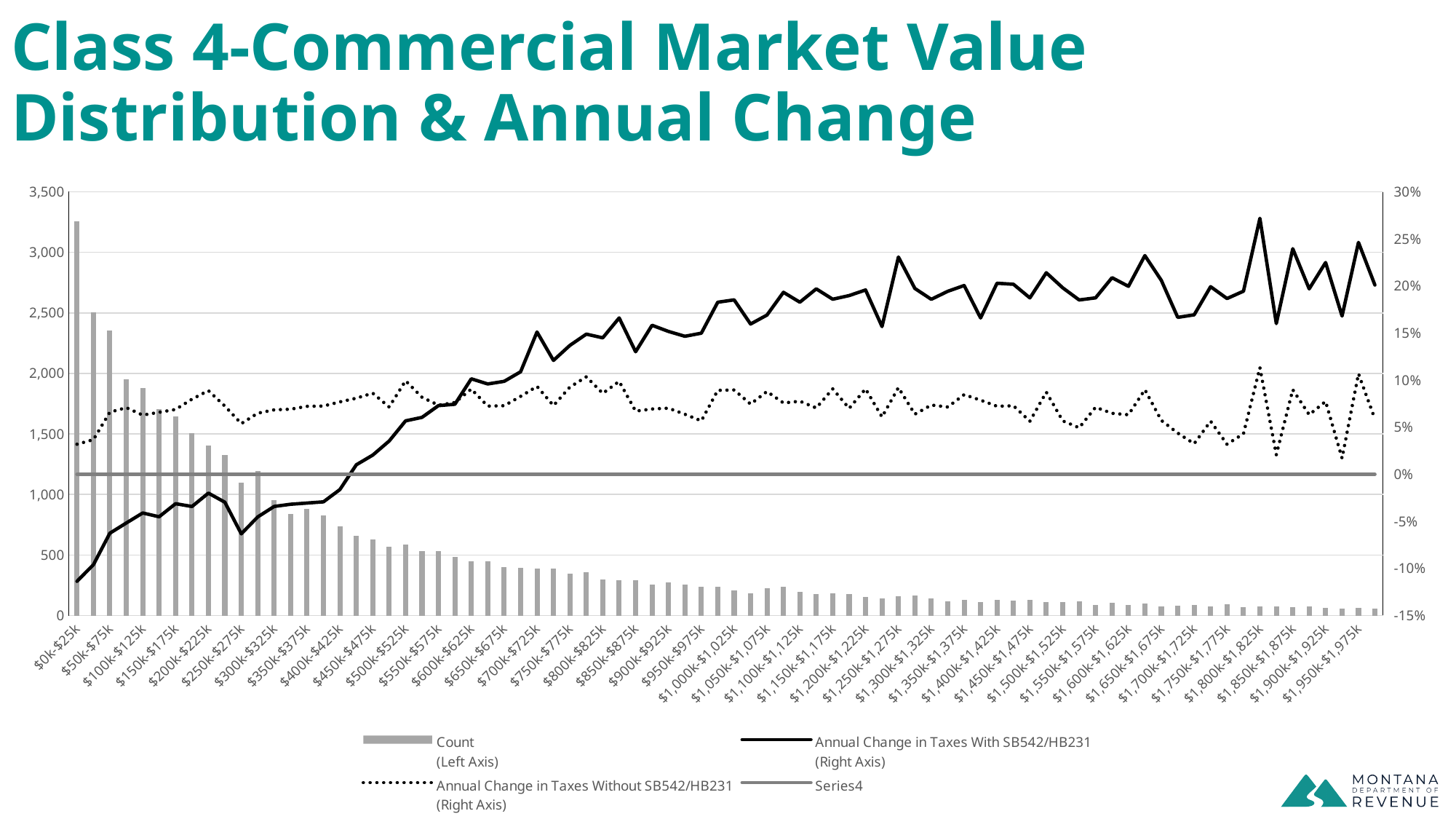
At $0k-$25k, which is higher: the Annual Change in Taxes With SB542/HB231 or Without SB542/HB231? Without SB542/HB231 Do the Count bars generally rise or fall as market value increases along the x axis? Fall What is the maximum value shown on the right-hand axis? 30% Does the Annual Change in Taxes With SB542/HB231 line generally rise or fall as market value increases along the x axis? Rise Which market value range has the highest Count? $0k-$25k How many series does the legend list? 4 Is the Count for $0k-$25k greater or less than 3,000? greater Which axis is the Count series plotted on? Left Axis Is the Annual Change in Taxes With SB542/HB231 for $0k-$25k greater or less than 0%? less What kind of chart is shown on the slide? A combined bar and line chart Is the Annual Change in Taxes With SB542/HB231 for $1,950k-$1,975k greater or less than 15%? greater At $1,950k-$1,975k, which is higher: the Annual Change in Taxes With SB542/HB231 or Without SB542/HB231? With SB542/HB231